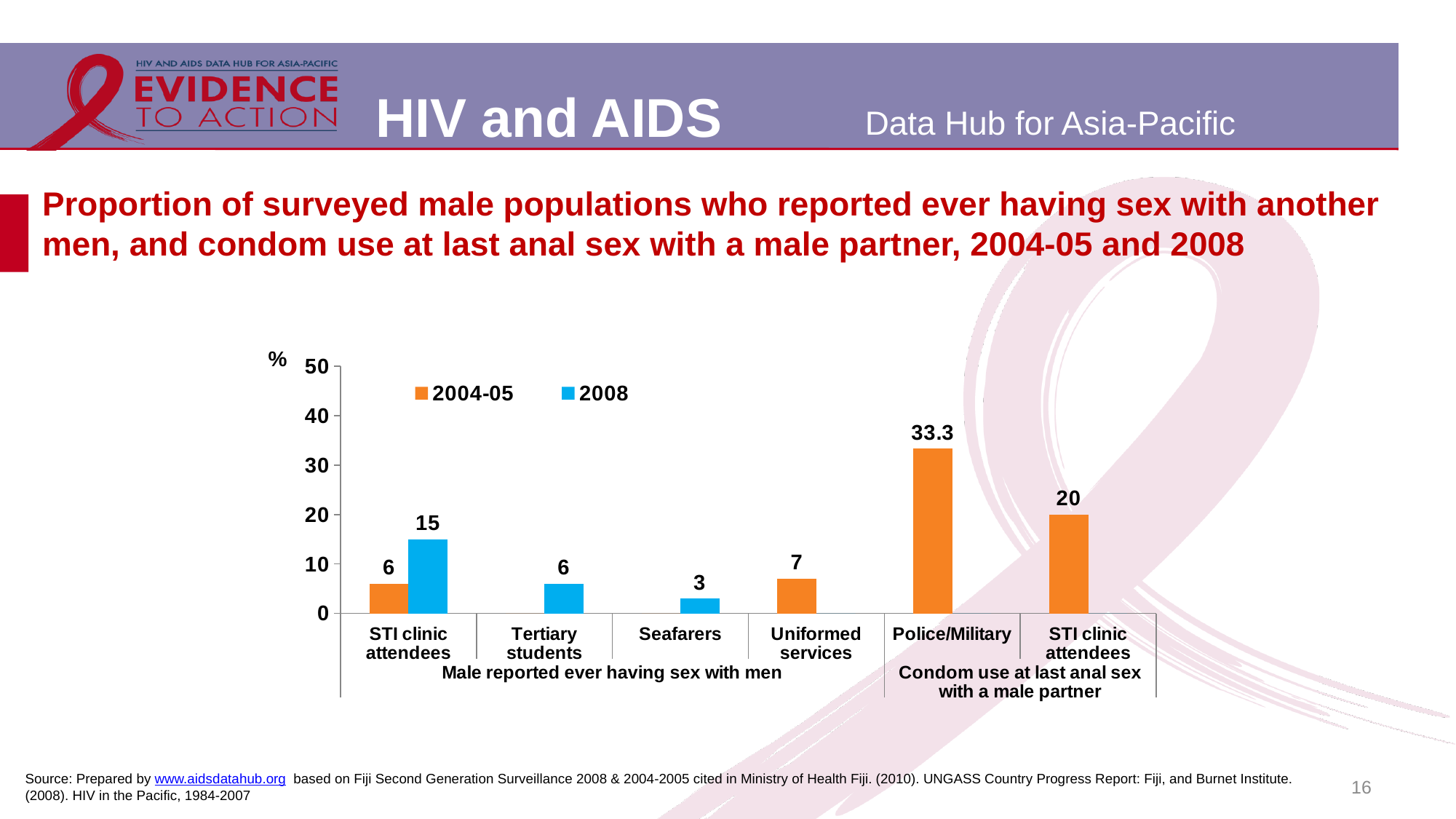
What is the 2004-05 value for Police/Military under 'Condom use at last anal sex with a male partner'? 33.3 Which is larger: the 2004-05 value for Police/Military or the 2004-05 value for STI clinic attendees under condom use? Police/Military What is the 2008 value for Seafarers? 3 Which colour represents the 2008 series in the chart? Blue What is the 2008 value for STI clinic attendees under 'Male reported ever having sex with men'? 15 What is the difference between the 2008 and 2004-05 values for STI clinic attendees under 'Male reported ever having sex with men'? 9 Which category has the highest value on the chart? Police/Military Is the 2004-05 value for Police/Military greater or less than 30? greater How many series does the legend list? 2 What is the 2004-05 value for Uniformed services? 7 What kind of chart is shown on the slide? Bar chart Which category has the lowest value on the chart? Seafarers